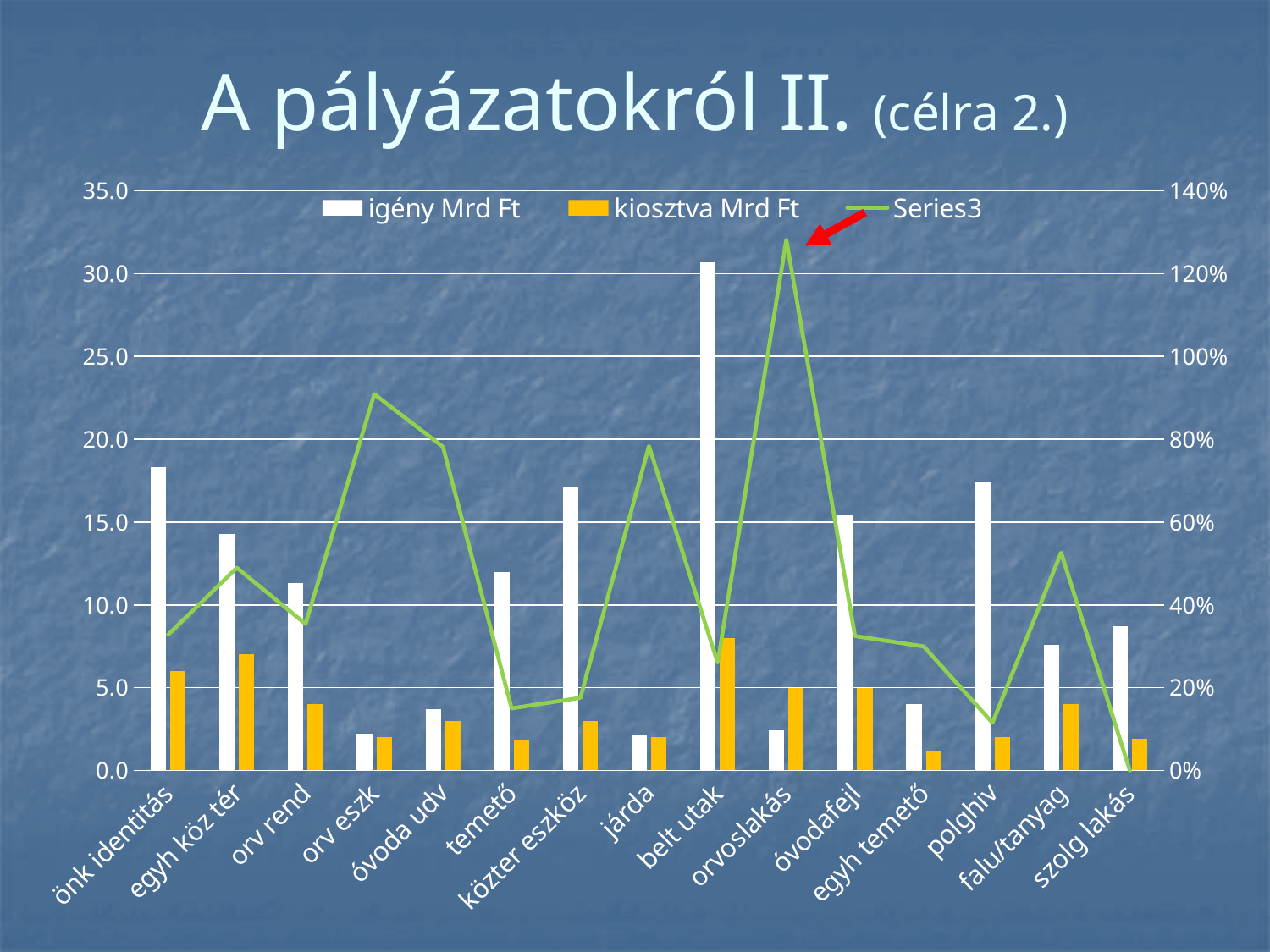
Is the igény Mrd Ft value for önk identitás greater or less than 15.0? greater Which category has the highest igény Mrd Ft bar? belt utak What kind of chart is this? Combination bar and line chart At which category does the Series3 line reach its lowest point? szolg lakás Is the Series3 value for temető greater or less than 20%? less How many series does the legend list? 3 Which has the larger igény Mrd Ft value, önk identitás or egyh köz tér? önk identitás What colour are the kiosztva Mrd Ft bars? Orange Which category has the lowest kiosztva Mrd Ft bar? egyh temető Which category has the highest kiosztva Mrd Ft bar? belt utak At which category does the Series3 line reach its highest point? orvoslakás How many categories are shown on the x axis? 15